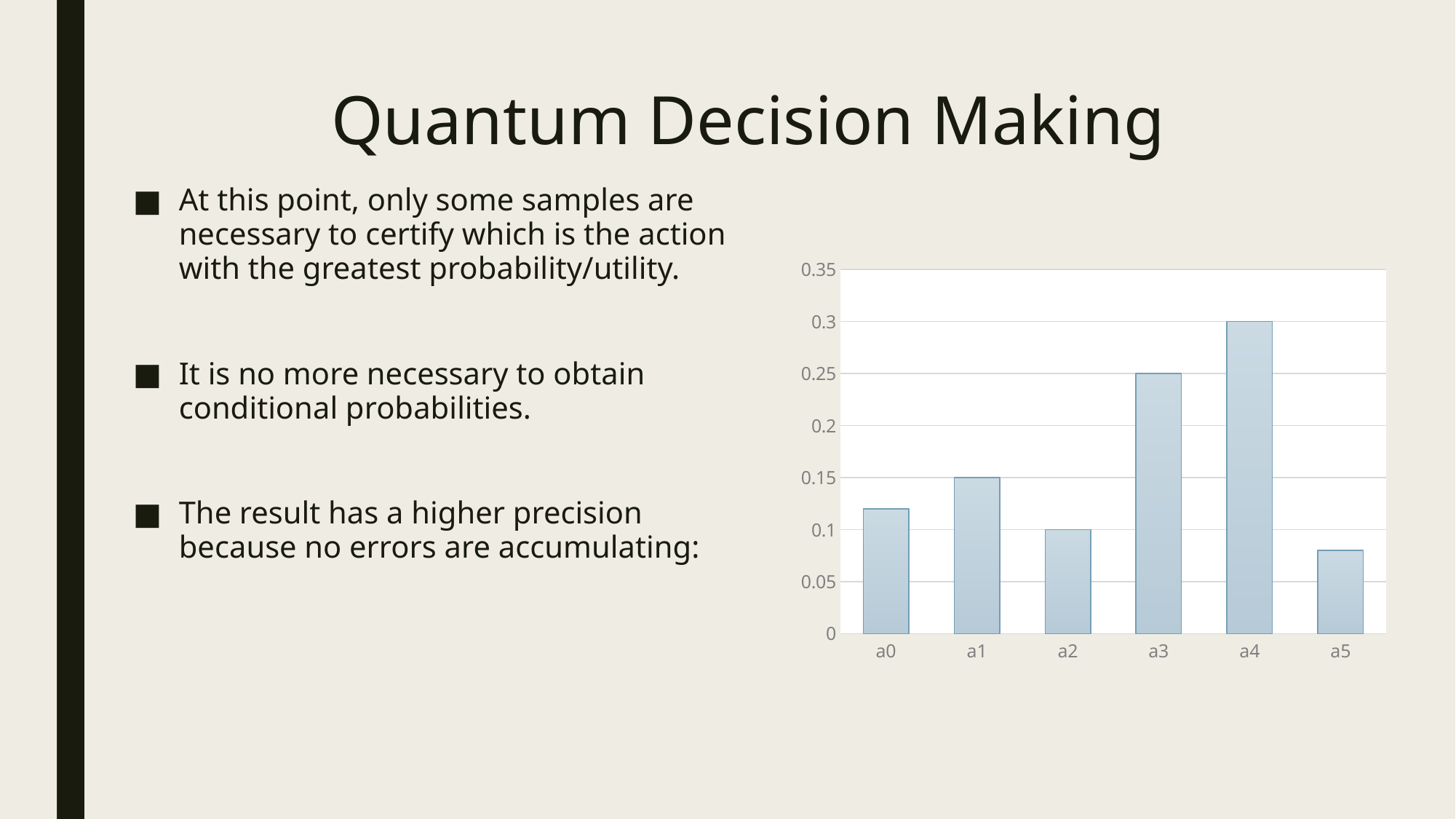
Which is larger, the value for a1 or the value for a2? a1 How many categories are shown on the x axis of the chart? 6 What is the difference between the values for a4 and a3? 0.05 What is the value for a4 in the chart? 0.3 What is the value for a3 in the chart? 0.25 Which category has the lowest bar in the chart? a5 What is the value for a2 in the chart? 0.1 Which category has the highest bar in the chart? a4 Is the value for a5 greater or less than 0.1? less What type of chart is shown on the slide? bar chart What is the value for a1 in the chart? 0.15 Is the value for a0 greater or less than 0.15? less